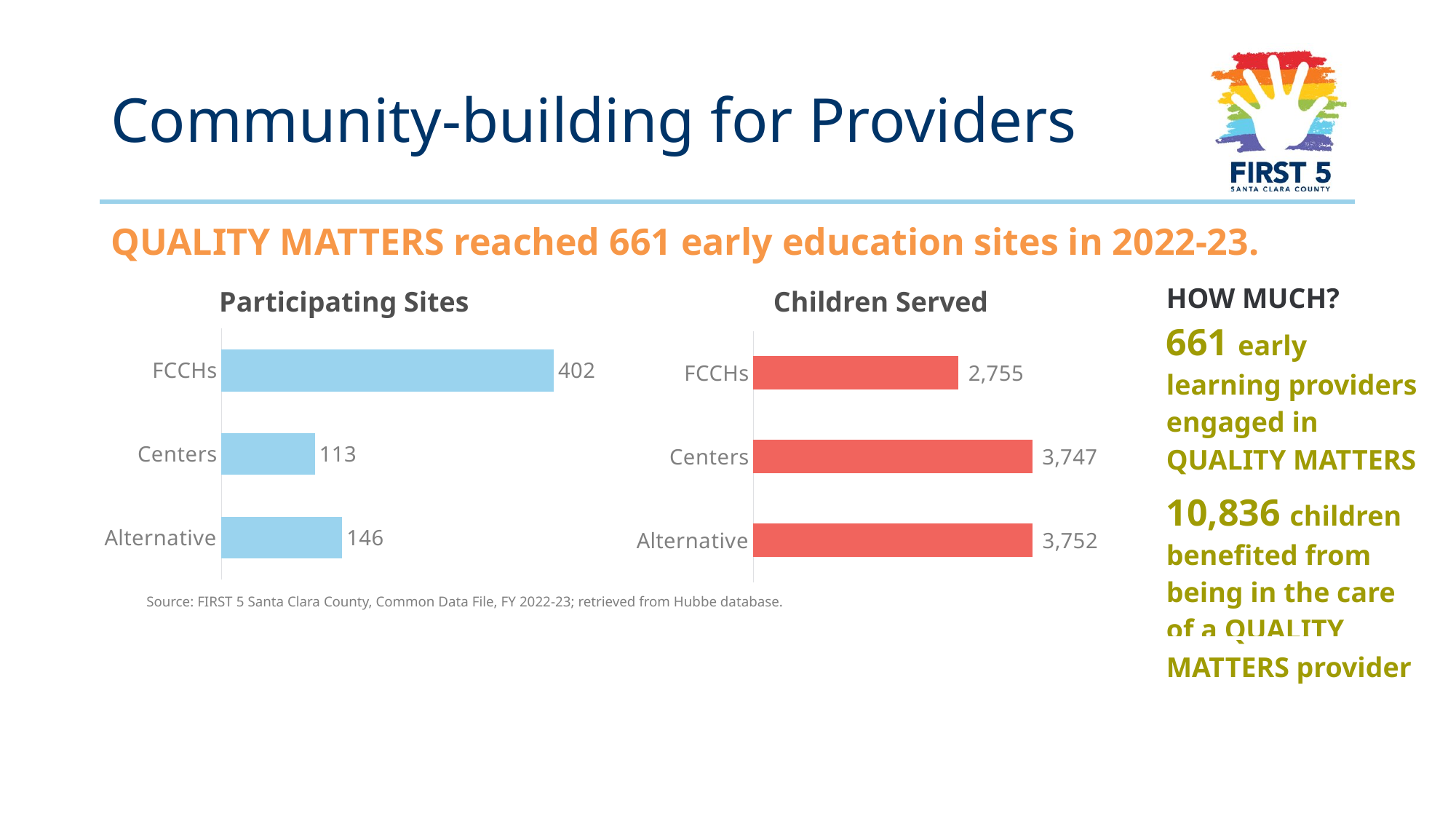
In the Participating Sites chart, what is the difference between the values for FCCHs and Alternative? 256 What kind of chart is the Participating Sites chart? Bar chart In the Participating Sites chart, what is the value for FCCHs? 402 In the Children Served chart, what is the difference between the values for Centers and FCCHs? 992 In the Participating Sites chart, which category has the highest value? FCCHs In the Participating Sites chart, what is the value for Centers? 113 In the Children Served chart, which category has the lowest value? FCCHs In the Participating Sites chart, which category has the lowest value? Centers In the Children Served chart, what is the value for Alternative? 3,752 How many categories does the Children Served chart show? 3 In the Children Served chart, what is the value for FCCHs? 2,755 In the Participating Sites chart, which is larger, the value for Alternative or the value for Centers? Alternative